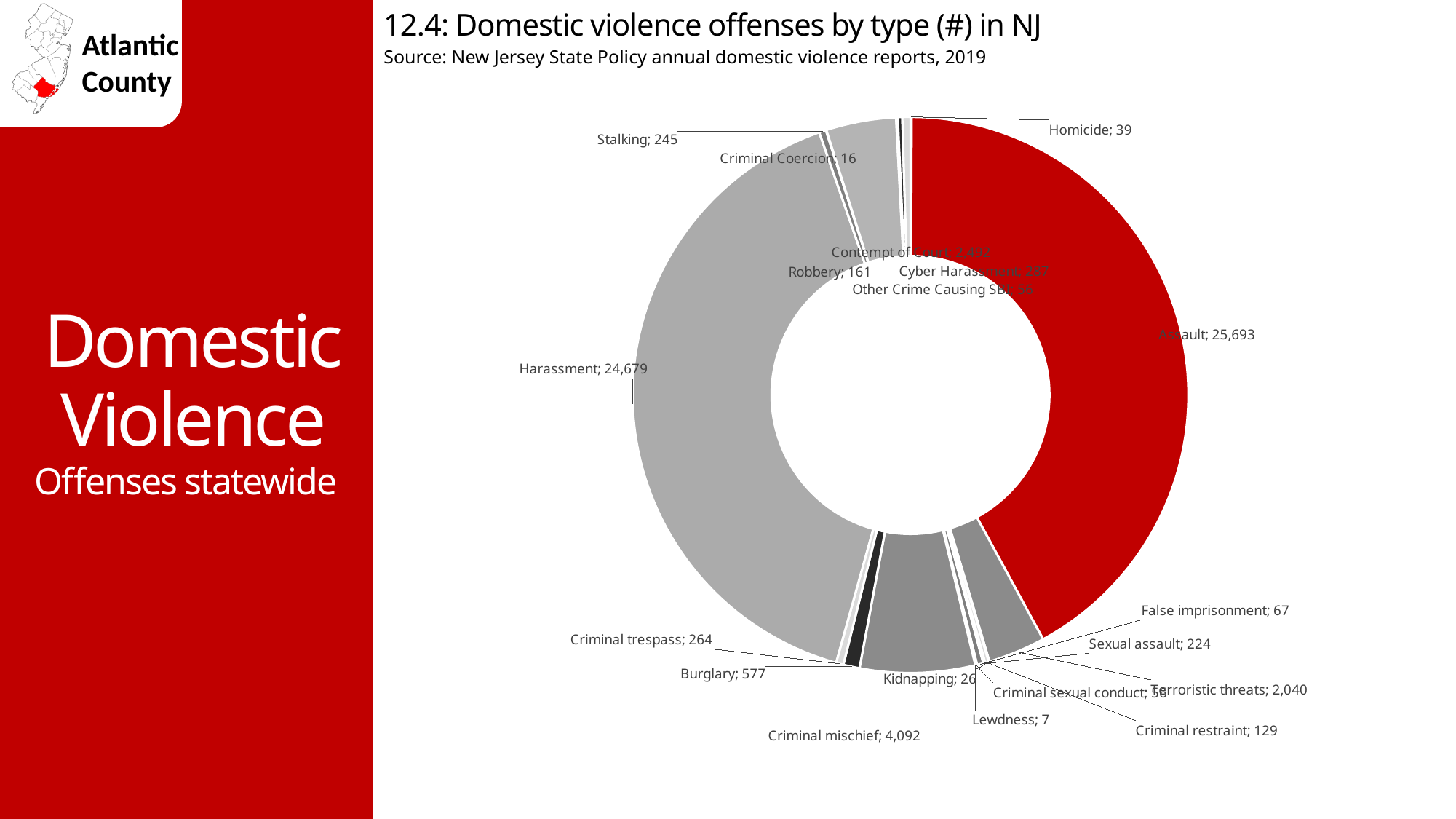
What is the value for Criminal mischief? 4,092 What is the source cited for the chart? New Jersey State Policy annual domestic violence reports, 2019 What is the value for Terroristic threats? 2,040 What is the value for Homicide? 39 What is the difference between Burglary and Criminal trespass? 313 What type of chart is shown on the slide? doughnut chart Which offense type has the largest slice? Assault How many domestic violence offenses of type Assault are shown? 25,693 What is the value for Harassment? 24,679 Which is larger, Stalking or Sexual assault? Stalking What is the difference between the Assault and Harassment values? 1,014 Which offense type has the smallest value? Lewdness